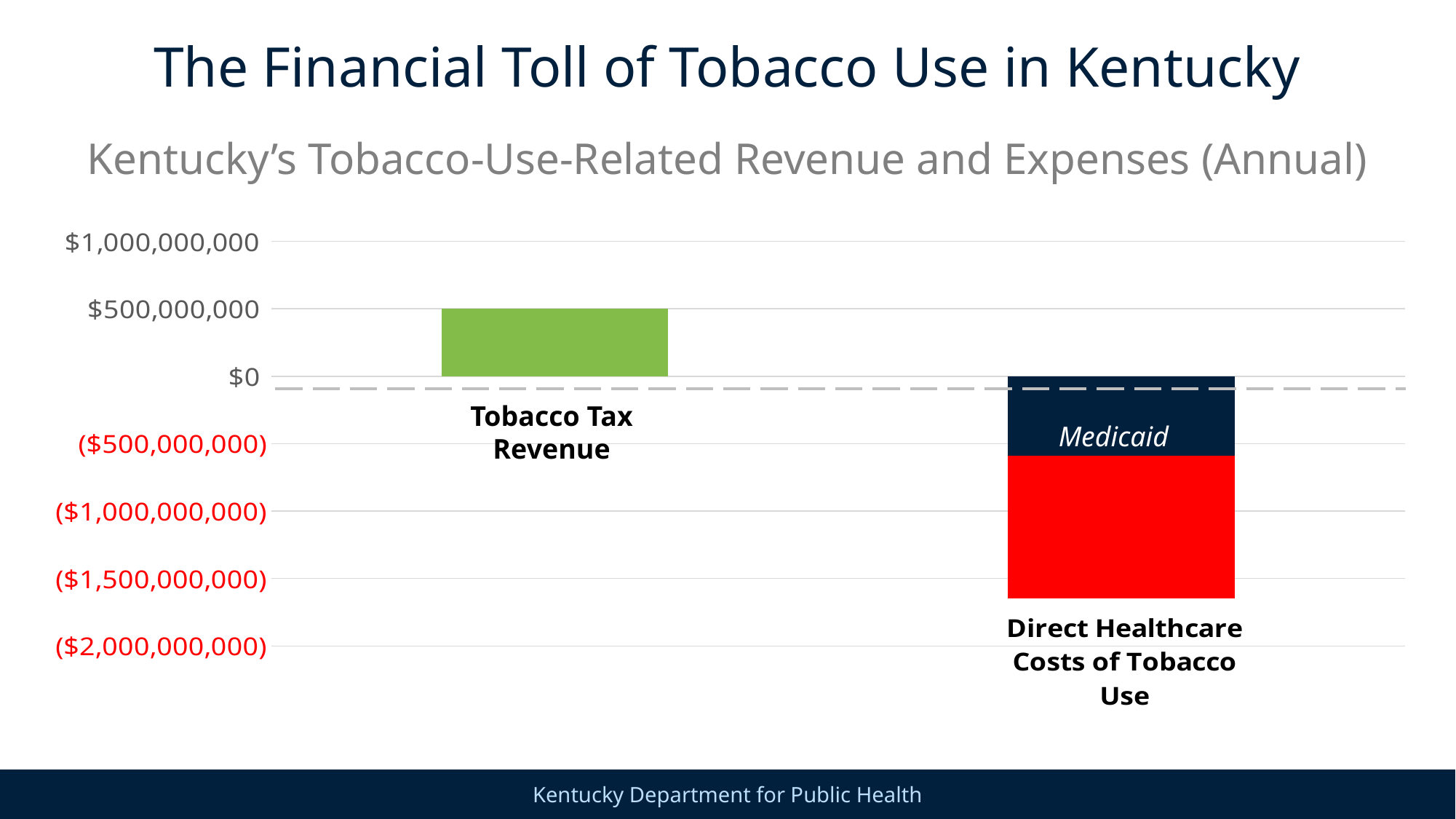
How many categories are plotted on the chart? 2 Which category has the lowest value on the chart? Direct Healthcare Costs of Tobacco Use What kind of chart is shown on the slide? Bar chart Which bar is larger in absolute size, Tobacco Tax Revenue or Direct Healthcare Costs of Tobacco Use? Direct Healthcare Costs of Tobacco Use What label appears inside the dark navy segment of the Direct Healthcare Costs of Tobacco Use bar? Medicaid Is the value of the Medicaid segment of the Direct Healthcare Costs of Tobacco Use bar greater or less than ($1,000,000,000)? greater Is the value for Tobacco Tax Revenue greater or less than $1,000,000,000? less Is the value for Direct Healthcare Costs of Tobacco Use greater or less than ($1,500,000,000)? less Is the Tobacco Tax Revenue bar above or below the $0 line? Above Which category has the highest value on the chart? Tobacco Tax Revenue What is the title of the chart? Kentucky's Tobacco-Use-Related Revenue and Expenses (Annual)